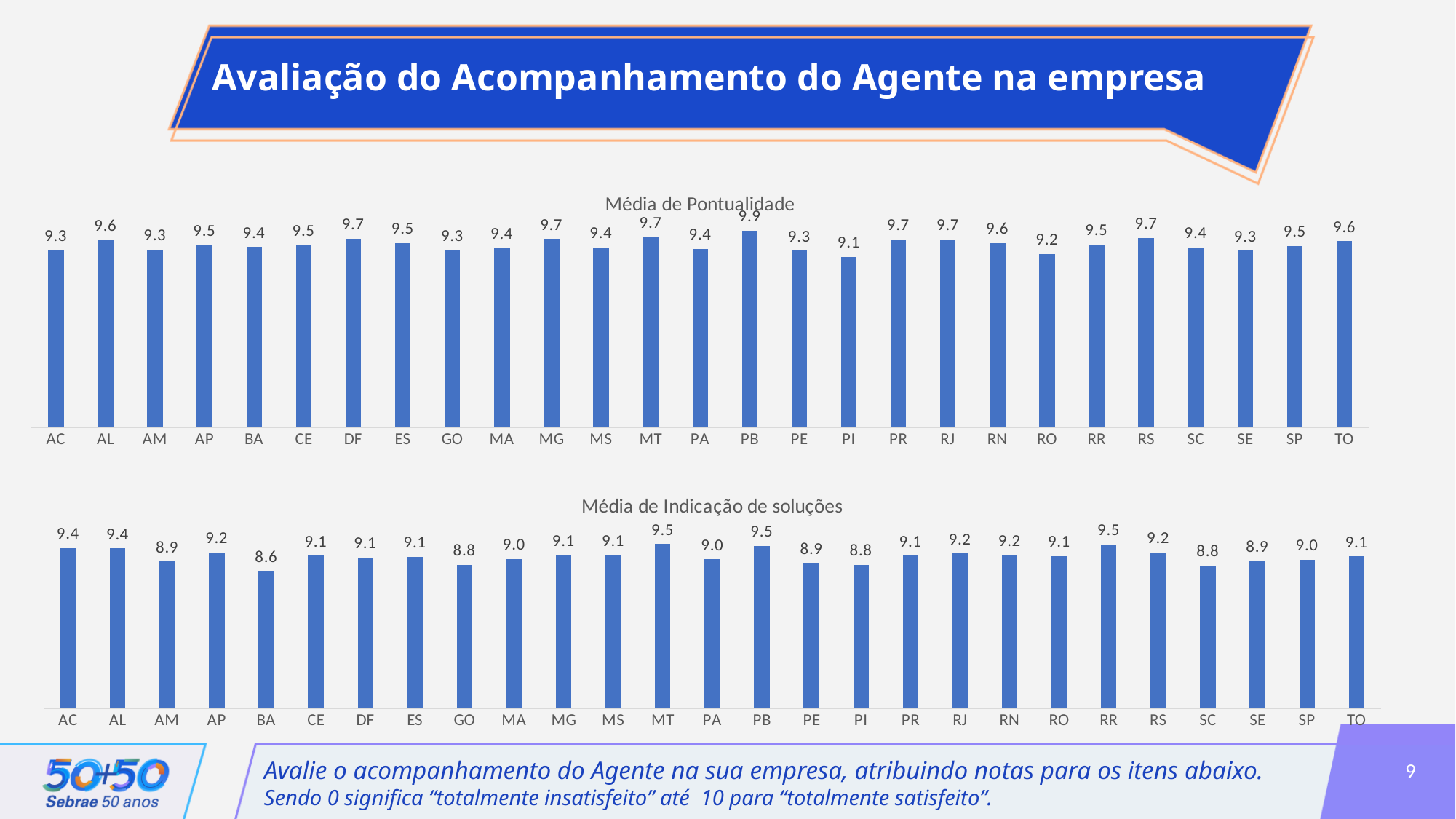
In the 'Média de Pontualidade' chart, what is the difference between the values for PB and PI? 0.8 In the 'Média de Indicação de soluções' chart, what is the value for MT? 9.5 In the 'Média de Indicação de soluções' chart, which is larger, the value for AC or the value for AM? AC What is the title of the bottom chart on the slide? Média de Indicação de soluções In the 'Média de Pontualidade' chart, which state has the lowest value? PI In the 'Média de Pontualidade' chart, which state has the highest value? PB In the 'Média de Indicação de soluções' chart, which state has the lowest value? BA How many states are shown in the 'Média de Indicação de soluções' chart? 27 In the 'Média de Pontualidade' chart, what is the value for PB? 9.9 In the 'Média de Pontualidade' chart, what is the difference between the values for AL and RO? 0.4 What kind of chart is the 'Média de Pontualidade' chart? Bar chart In the 'Média de Indicação de soluções' chart, what is the value for BA? 8.6